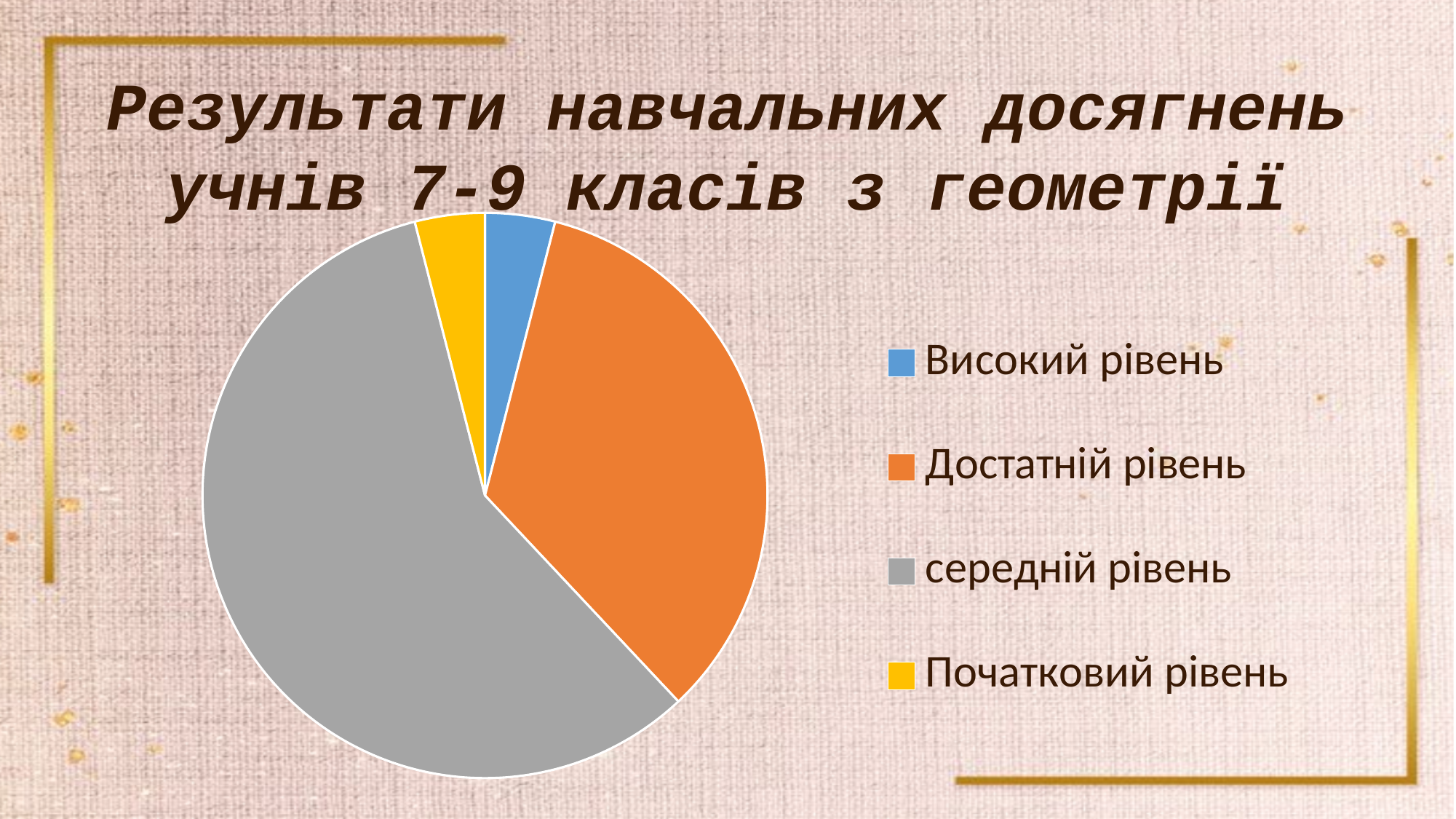
What kind of chart is shown on the slide? pie chart Which category has the largest slice of the pie? середній рівень Which slice is larger: Початковий рівень or середній рівень? середній рівень Which slice is larger: Високий рівень or Достатній рівень? Достатній рівень Which slice is larger: Достатній рівень or середній рівень? середній рівень What is the title of the slide containing the chart? Результати навчальних досягнень учнів 7-9 класів з геометрії How many entries does the legend list? 4 Which colour represents Початковий рівень in the pie chart? yellow How many slices does the pie chart have? 4